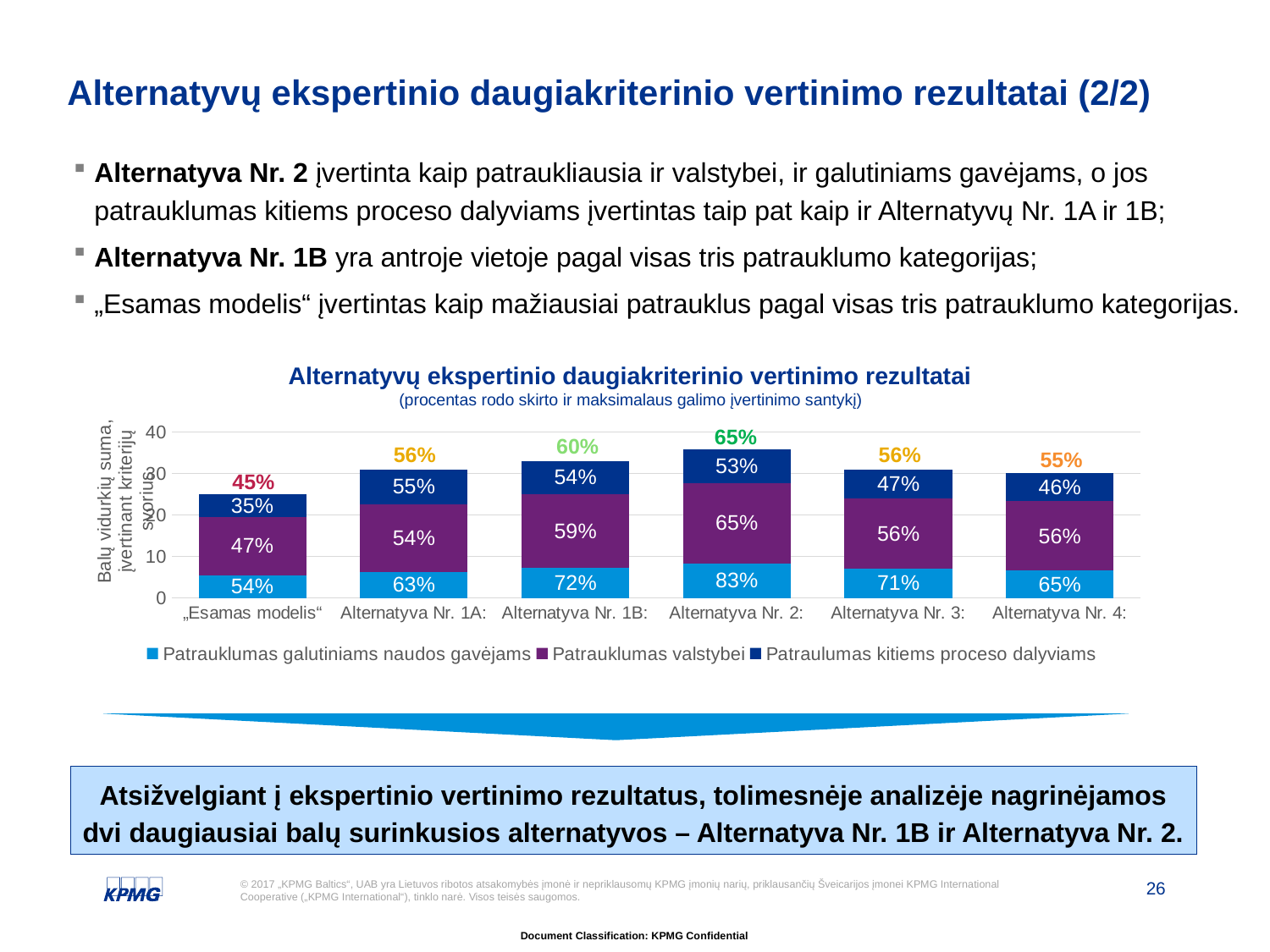
How many series does the chart legend list? 3 What percentage is labelled on the "Patrauklumas valstybei" segment for Alternatyva Nr. 3? 56% What kind of chart is shown on the slide? Stacked bar chart Which alternative has the highest overall percentage shown above its bar? Alternatyva Nr. 2 What percentage is labelled on the "Patrauklumas galutiniams naudos gavėjams" segment for Alternatyva Nr. 1B? 72% What percentage is labelled on the "Patraulumas kitiems proceso dalyviams" segment for Alternatyva Nr. 4? 46% How many alternatives (categories) are shown on the x axis of the chart? 6 Which alternative has the lowest overall percentage shown above its bar? "Esamas modelis" What is the overall percentage shown above the bar for Alternatyva Nr. 2? 65% Which has the higher "Patrauklumas galutiniams naudos gavėjams" percentage: Alternatyva Nr. 1A or Alternatyva Nr. 3? Alternatyva Nr. 3 What is the overall percentage shown above the bar for "Esamas modelis"? 45% Is the total bar height for Alternatyva Nr. 2 greater or less than 30 on the y axis? greater